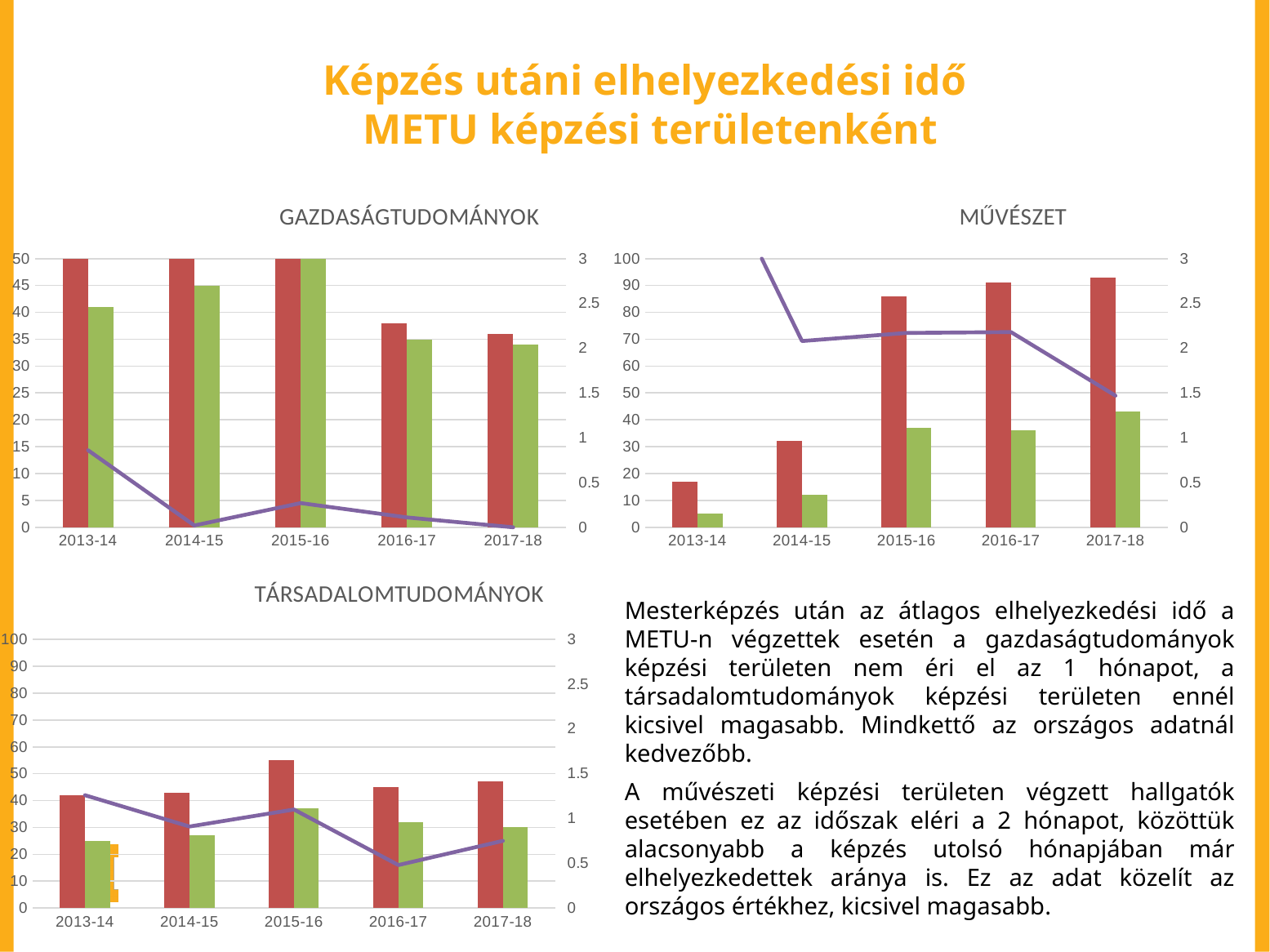
In the MŰVÉSZET chart, is the red bar for 2015-16 greater or less than 80? greater In the GAZDASÁGTUDOMÁNYOK chart, what is the value of the red bar for 2013-14? 50 In the MŰVÉSZET chart, which year has the highest red bar? 2017-18 In the MŰVÉSZET chart, which red bar is larger, 2014-15 or 2015-16? 2015-16 In the TÁRSADALOMTUDOMÁNYOK chart, is the red bar for 2015-16 greater or less than 50? greater What kind of chart is the GAZDASÁGTUDOMÁNYOK chart? bar chart with a line In the GAZDASÁGTUDOMÁNYOK chart, is the green bar for 2016-17 greater or less than 40? less In the MŰVÉSZET chart, which year has the lowest red bar? 2013-14 In the MŰVÉSZET chart, do the red bars rise or fall from 2013-14 to 2017-18? rise How many categories are shown on the x axis of the MŰVÉSZET chart? 5 In the TÁRSADALOMTUDOMÁNYOK chart, which year has the highest red bar? 2015-16